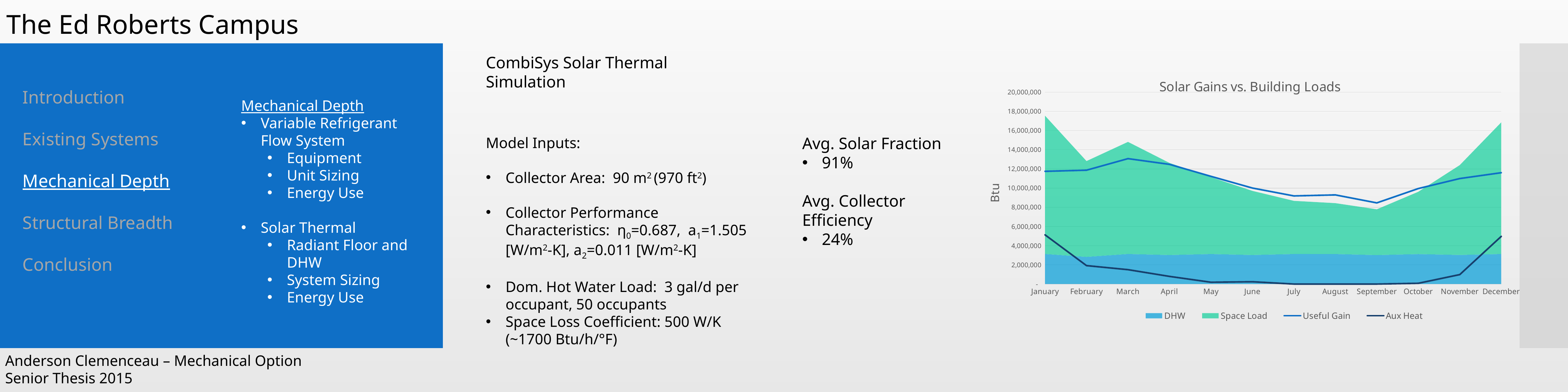
What kind of chart is 'Solar Gains vs. Building Loads'? combination area and line chart How many series does the legend of the 'Solar Gains vs. Building Loads' chart list? 4 In the 'Solar Gains vs. Building Loads' chart, in which month is the Useful Gain line highest? March In the 'Solar Gains vs. Building Loads' chart, is the Aux Heat value for January greater or less than 4,000,000? greater In the 'Solar Gains vs. Building Loads' chart, does the Aux Heat line rise or fall from January to July? fall In the 'Solar Gains vs. Building Loads' chart, is the Useful Gain value for March greater or less than 12,000,000? greater What unit is shown on the y axis of the 'Solar Gains vs. Building Loads' chart? Btu In the 'Solar Gains vs. Building Loads' chart, in which month is the Useful Gain line lowest? September In the 'Solar Gains vs. Building Loads' chart, is the DHW value for June greater or less than 4,000,000? less What is the title of the chart on the slide? Solar Gains vs. Building Loads In the 'Solar Gains vs. Building Loads' chart, in which month is the combined DHW plus Space Load area highest? January How many months are shown on the x axis of the 'Solar Gains vs. Building Loads' chart? 12